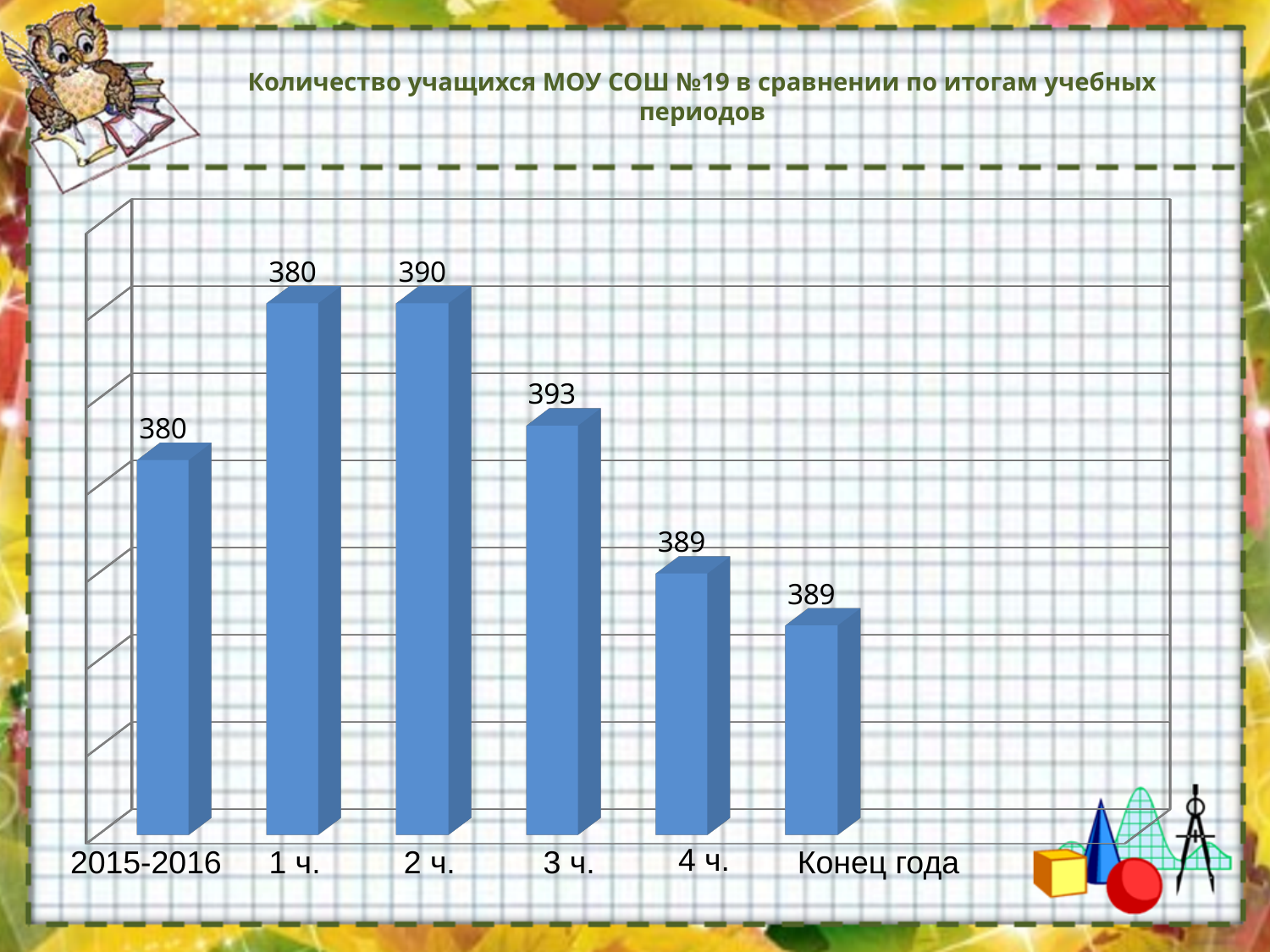
What is the value for 3 ч.? 393 How many categories are shown on the x axis? 6 What is the value for 2015-2016? 380 What colour are the bars in the chart? blue What is the difference between the values for 3 ч. and 1 ч.? 13 What is the value for Конец года? 389 What is the title of the chart? Количество учащихся МОУ СОШ №19 в сравнении по итогам учебных периодов What is the value for 2 ч.? 390 According to the data labels, which category has the highest value? 3 ч. What kind of chart is shown on the slide? bar chart According to the data labels, which is larger: the value for 2 ч. or the value for 3 ч.? 3 ч. What is the difference between the values for 2 ч. and 4 ч.? 1